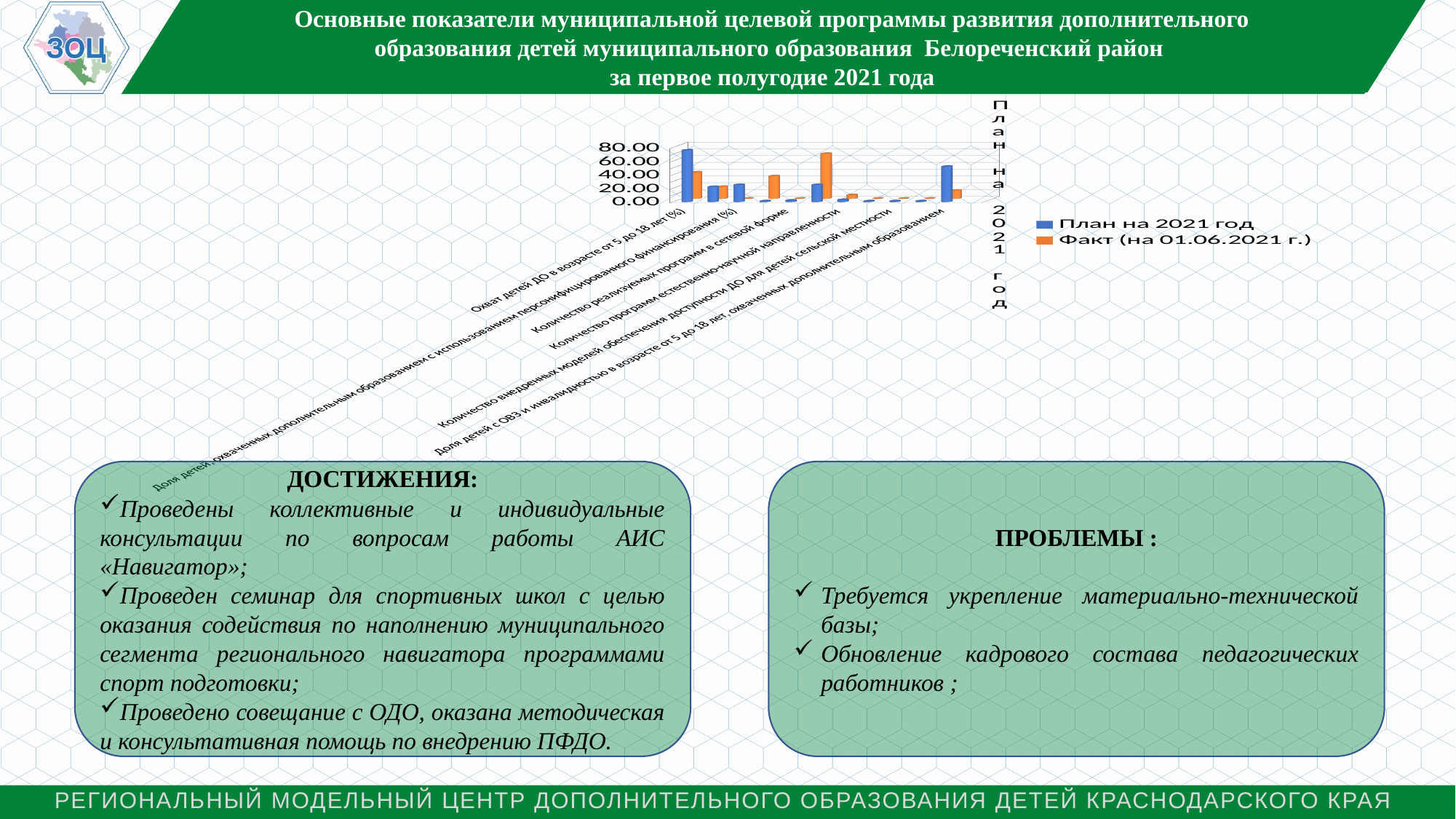
For 'Охват детей ДО в возрасте от 5 до 18 лет (%)', which is larger: the 'План на 2021 год' value or the 'Факт (на 01.06.2021 г.)' value? План на 2021 год What colour are the bars for the series 'Факт (на 01.06.2021 г.)'? orange Is the 'Факт (на 01.06.2021 г.)' value for 'Охват детей ДО в возрасте от 5 до 18 лет (%)' greater or less than 60.00? less For 'Количество программ естественно-научной направленности', which is larger: the 'План на 2021 год' value or the 'Факт (на 01.06.2021 г.)' value? Факт (на 01.06.2021 г.) Is the 'План на 2021 год' value for 'Охват детей ДО в возрасте от 5 до 18 лет (%)' greater or less than 60.00? greater What are the two series named in the chart legend? План на 2021 год; Факт (на 01.06.2021 г.) Which category has the highest value for the series 'План на 2021 год'? Охват детей ДО в возрасте от 5 до 18 лет (%) What kind of chart is shown on the slide? bar chart How many series does the chart legend list? 2 Is the 'Факт (на 01.06.2021 г.)' value for 'Количество программ естественно-научной направленности' greater or less than 60.00? less